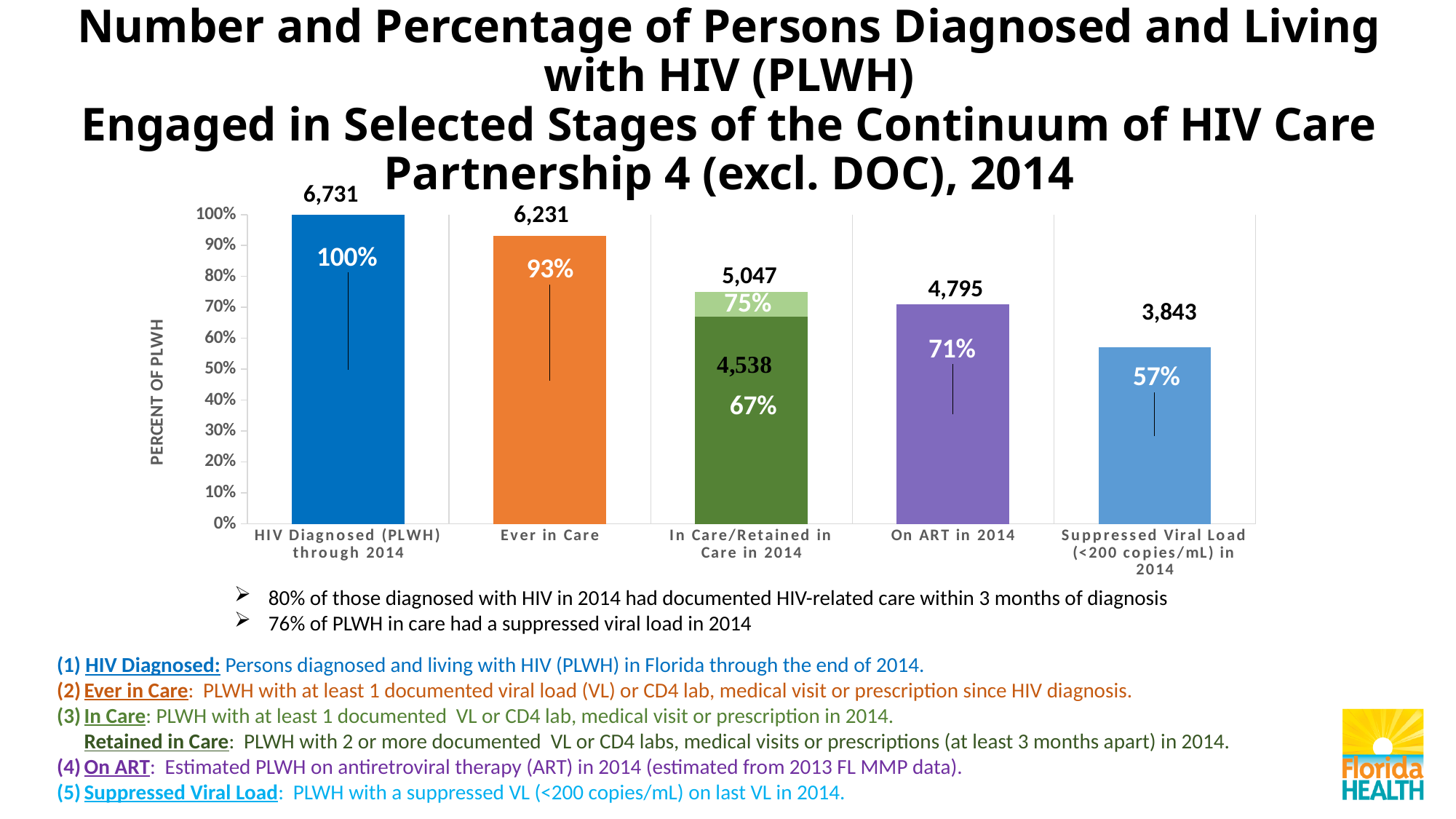
How many categories are shown on the x axis? 5 Which is larger, the percentage for On ART in 2014 or the percentage for Suppressed Viral Load (<200 copies/mL) in 2014? On ART in 2014 What kind of chart is shown on the slide? Bar chart Do the percentages rise or fall moving from left to right across the categories? Fall What percentage is shown for the darker green Retained in Care portion of the In Care/Retained in Care in 2014 bar? 67% Which category has the lowest percentage? Suppressed Viral Load (<200 copies/mL) in 2014 What is the difference in number of persons between HIV Diagnosed (PLWH) through 2014 and Ever in Care? 500 What number is printed above the HIV Diagnosed (PLWH) through 2014 bar? 6,731 What percentage is shown for Suppressed Viral Load (<200 copies/mL) in 2014? 57% What percentage is shown for the Ever in Care bar? 93% What number is printed above the On ART in 2014 bar? 4,795 Which category has the highest percentage? HIV Diagnosed (PLWH) through 2014